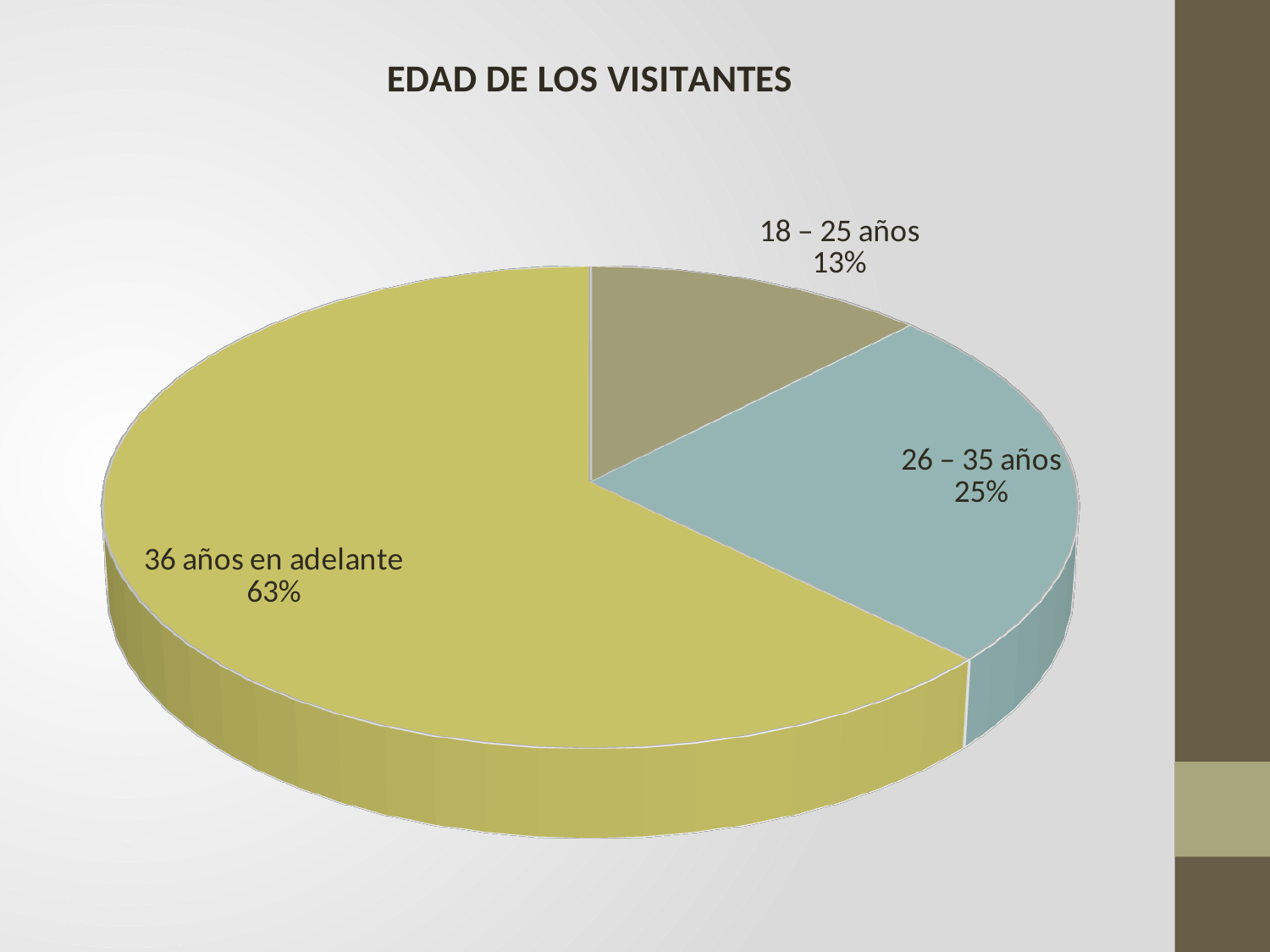
What percentage of visitors are 36 años en adelante? 63% What percentage of visitors are in the 18 – 25 años group? 13% What is the difference in percentage points between the 36 años en adelante group and the 26 – 35 años group? 38 Which age group has the smallest share of visitors? 18 – 25 años What is the difference in percentage points between the 26 – 35 años group and the 18 – 25 años group? 12 Which group has a larger share: 26 – 35 años or 18 – 25 años? 26 – 35 años What kind of chart is shown on the slide? Pie chart What is the title of the chart? EDAD DE LOS VISITANTES What colour is the slice for 26 – 35 años? Blue-grey (teal) What percentage of visitors are in the 26 – 35 años group? 25% How many age groups are shown in the pie chart? 3 Which age group has the largest share of visitors? 36 años en adelante